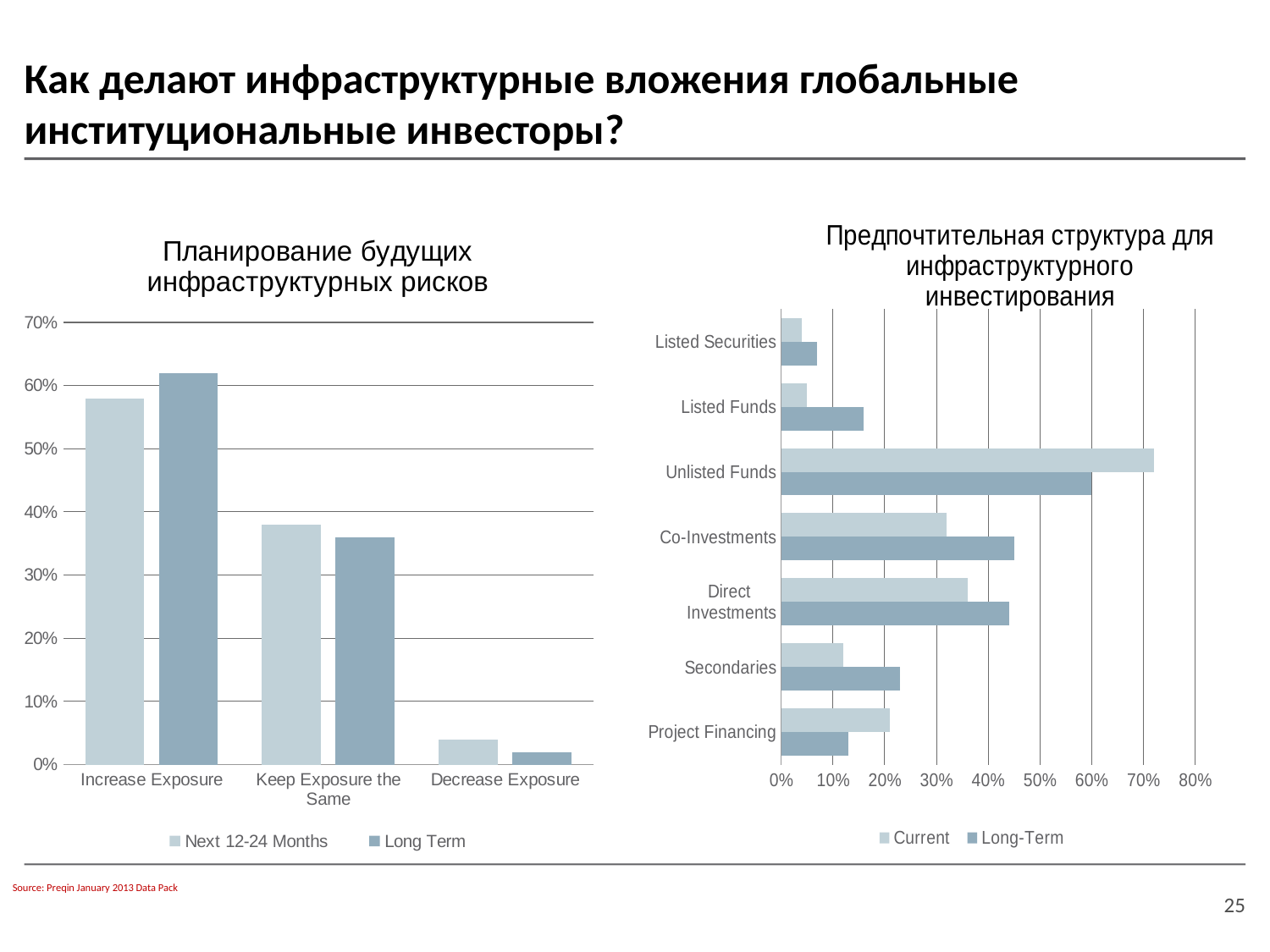
In the left chart "Планирование будущих инфраструктурных рисков", do the Next 12-24 Months values rise or fall from Increase Exposure to Decrease Exposure? fall In the left chart "Планирование будущих инфраструктурных рисков", which is larger for Keep Exposure the Same: Next 12-24 Months or Long Term? Next 12-24 Months In the right chart "Предпочтительная структура для инфраструктурного инвестирования", is the Current value for Unlisted Funds greater or less than 70%? greater How many categories are listed on the right chart "Предпочтительная структура для инфраструктурного инвестирования"? 7 What kind of chart is the left chart titled "Планирование будущих инфраструктурных рисков"? bar chart In the right chart "Предпочтительная структура для инфраструктурного инвестирования", which is larger for Project Financing: Current or Long-Term? Current In the right chart "Предпочтительная структура для инфраструктурного инвестирования", which category has the highest Current value? Unlisted Funds How many categories are shown on the x axis of the left chart "Планирование будущих инфраструктурных рисков"? 3 How many series does the legend of the left chart "Планирование будущих инфраструктурных рисков" list? 2 In the left chart "Планирование будущих инфраструктурных рисков", is the Next 12-24 Months value for Increase Exposure greater or less than 50%? greater What are the two legend entries of the right chart "Предпочтительная структура для инфраструктурного инвестирования"? Current and Long-Term In the left chart "Планирование будущих инфраструктурных рисков", which category has the highest Long Term value? Increase Exposure